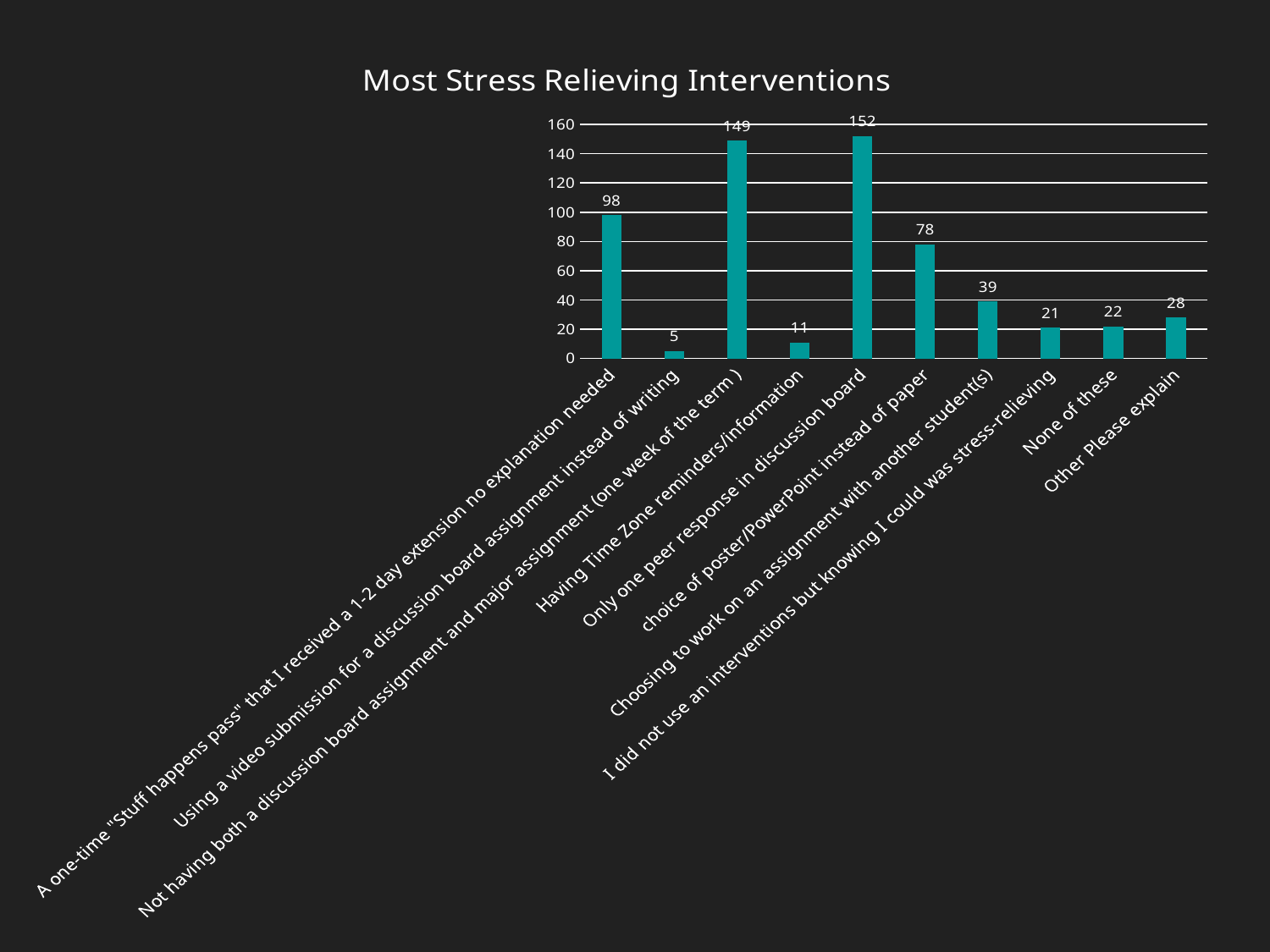
What is the value for "None of these"? 22 How many categories are shown on the chart? 10 Which category has the highest value? Only one peer response in discussion board What is the value for "choice of poster/PowerPoint instead of paper"? 78 What is the value for "Only one peer response in discussion board"? 152 Which is larger: the value for "Choosing to work on an assignment with another student(s)" or the value for "Other Please explain"? Choosing to work on an assignment with another student(s) What is the difference between the values for "Only one peer response in discussion board" and "Not having both a discussion board assignment and major assignment (one week of the term)"? 3 What is the value for "Having Time Zone reminders/information"? 11 What is the title of the chart? Most Stress Relieving Interventions What kind of chart is shown on the slide? Bar chart Which category has the lowest value? Using a video submission for a discussion board assignment instead of writing Is the value for the "Stuff happens pass" category greater or less than 80? greater